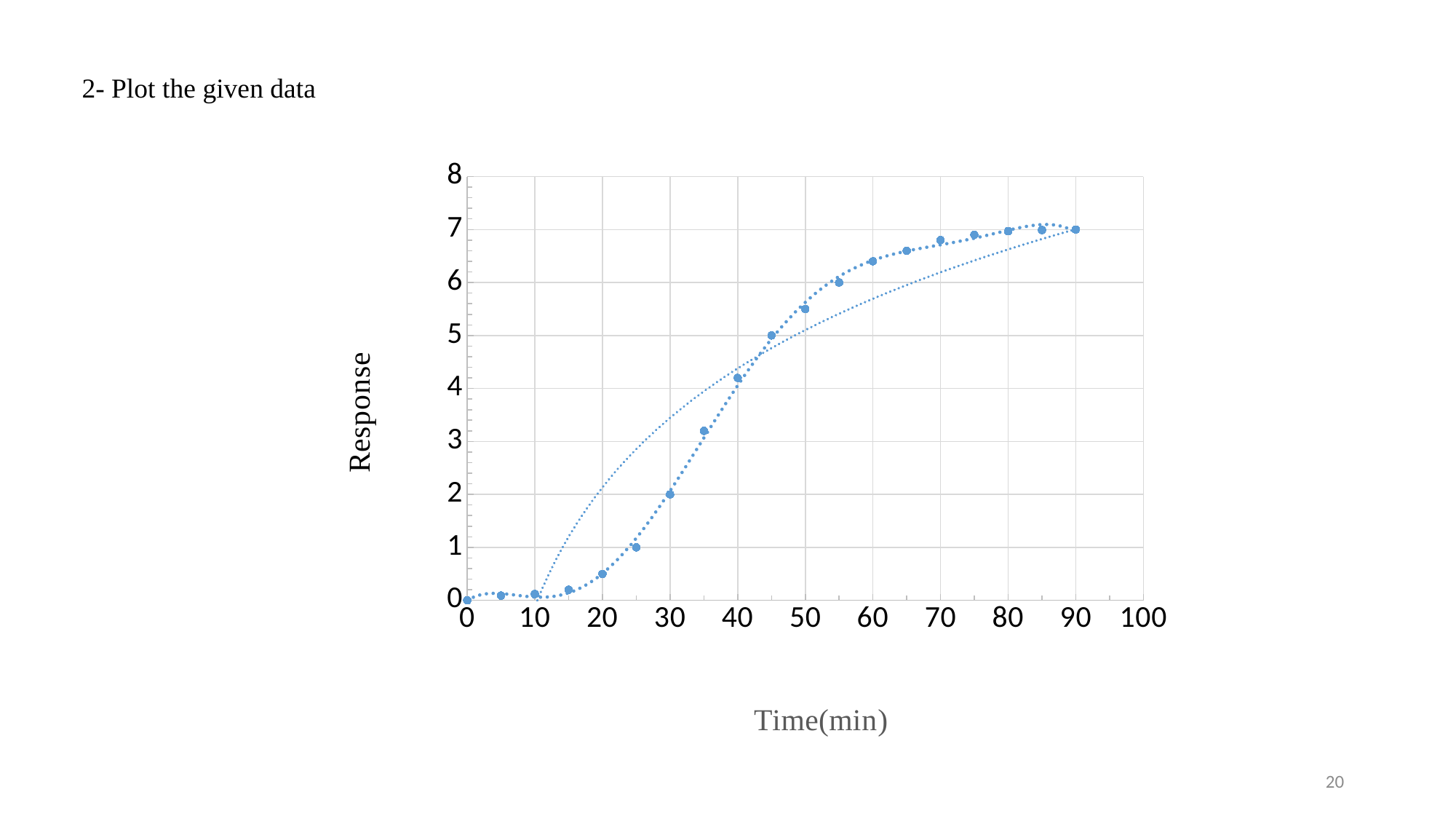
What kind of chart is shown on the slide? scatter chart with a dotted line Do the plotted Response values rise or fall as Time increases? rise What is the title of the y axis? Response What is the Response value at Time 30 min? 2 Is the Response value at Time 20 min greater or less than 1? less How many data points are plotted on the chart? 19 What is the title of the x axis? Time(min) What is the Response value at Time 0 min? 0 What is the Response value at Time 45 min? 5 Is the Response value at Time 40 min greater or less than 5? less Which is larger, the Response at Time 35 min or at Time 50 min? Time 50 min Is the Response value at Time 60 min greater or less than 6? greater